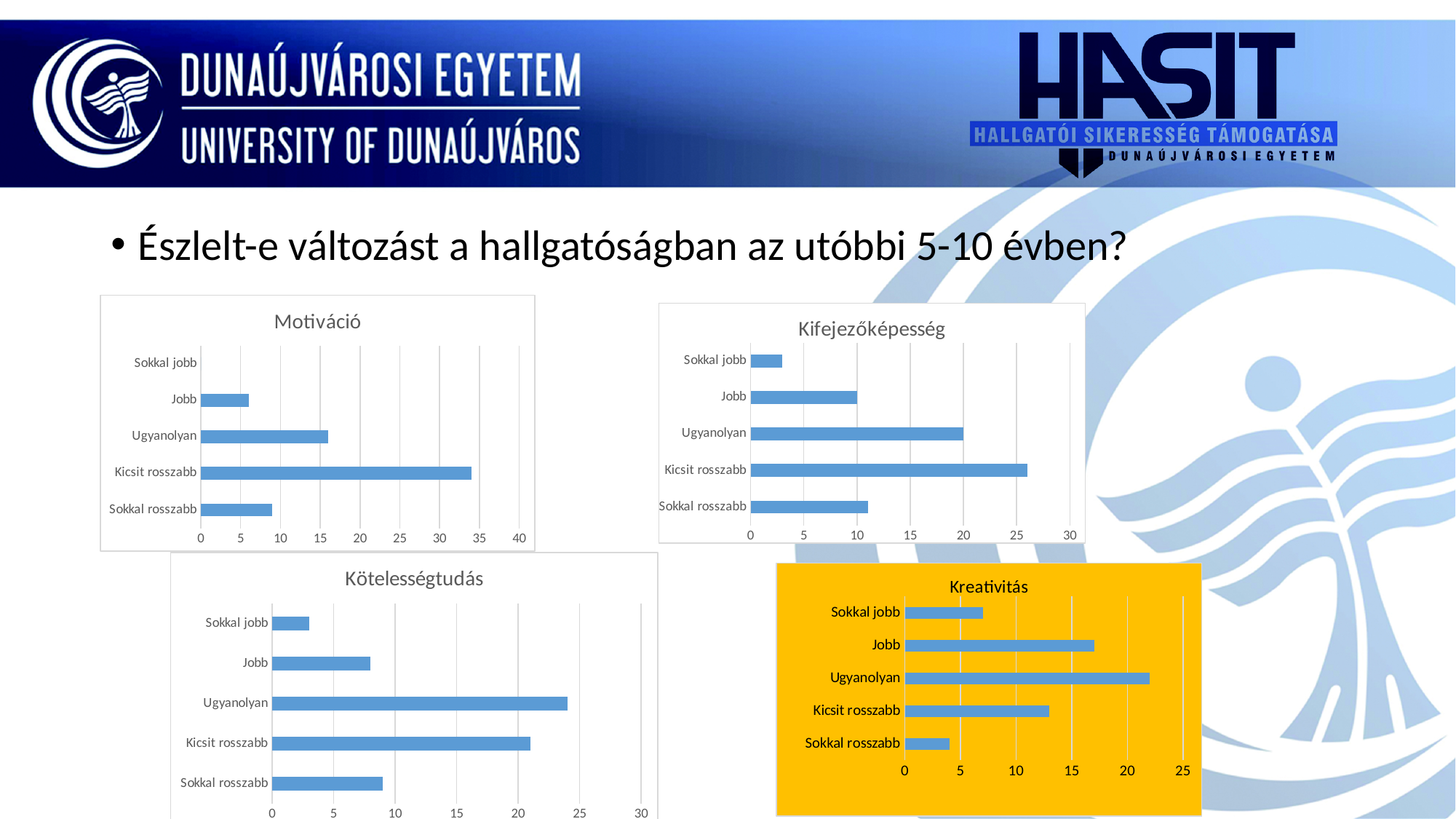
In the Kötelességtudás chart, which category has the highest value? Ugyanolyan In the Kreativitás chart, which is larger, Jobb or Kicsit rosszabb? Jobb In the Kötelességtudás chart, is the value for Ugyanolyan greater or less than 20? greater What kind of chart is the Motiváció chart? bar chart In the Kifejezőképesség chart, which is larger, Ugyanolyan or Jobb? Ugyanolyan How many categories are shown in the Kreativitás chart? 5 In the Motiváció chart, which category has the highest value? Kicsit rosszabb In the Motiváció chart, is the value for Ugyanolyan greater or less than 20? less In the Kreativitás chart, which category has the lowest value? Sokkal rosszabb In the Kifejezőképesség chart, which category has the lowest value? Sokkal jobb In the Motiváció chart, is the value for Kicsit rosszabb greater or less than 30? greater In the Kifejezőképesség chart, which category has the highest value? Kicsit rosszabb